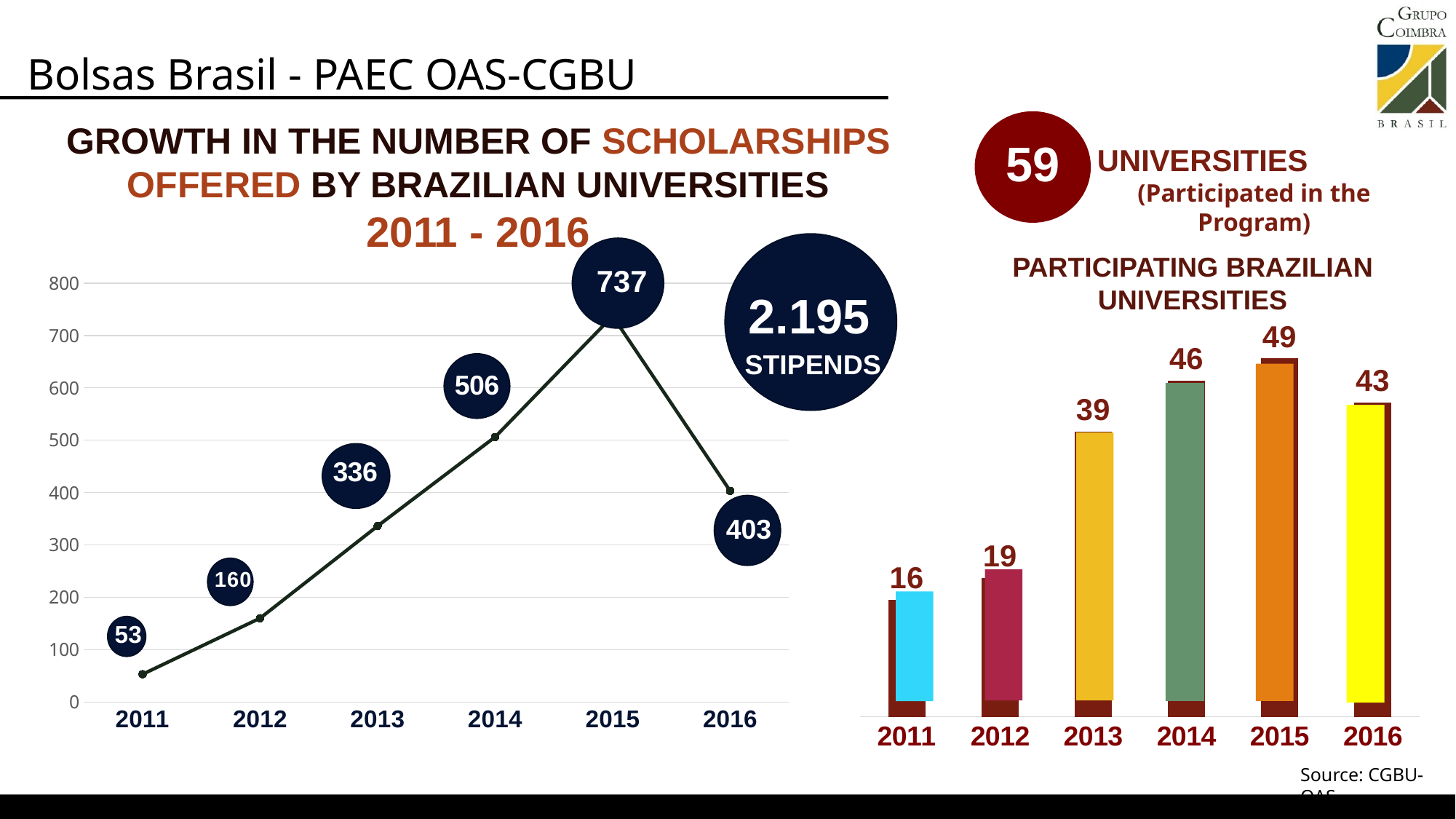
What kind of chart is the 'Growth in the number of scholarships' chart? line chart In the 'Growth in the number of scholarships' chart, what is the value for 2011? 53 In the 'Participating Brazilian Universities' chart, what is the difference between the values for 2013 and 2012? 20 In the 'Growth in the number of scholarships' chart, which year has the lowest value? 2011 What kind of chart is the 'Participating Brazilian Universities' chart? bar chart In the 'Participating Brazilian Universities' chart, which year has the lowest value? 2011 In the 'Participating Brazilian Universities' chart, which year has the highest value? 2015 In the 'Growth in the number of scholarships' chart, how many years are plotted? 6 In the 'Growth in the number of scholarships' chart, what is the value for 2015? 737 In the 'Growth in the number of scholarships' chart, what is the difference between the values for 2015 and 2016? 334 In the 'Growth in the number of scholarships' chart, which year has the highest value? 2015 In the 'Participating Brazilian Universities' chart, what is the value for 2014? 46